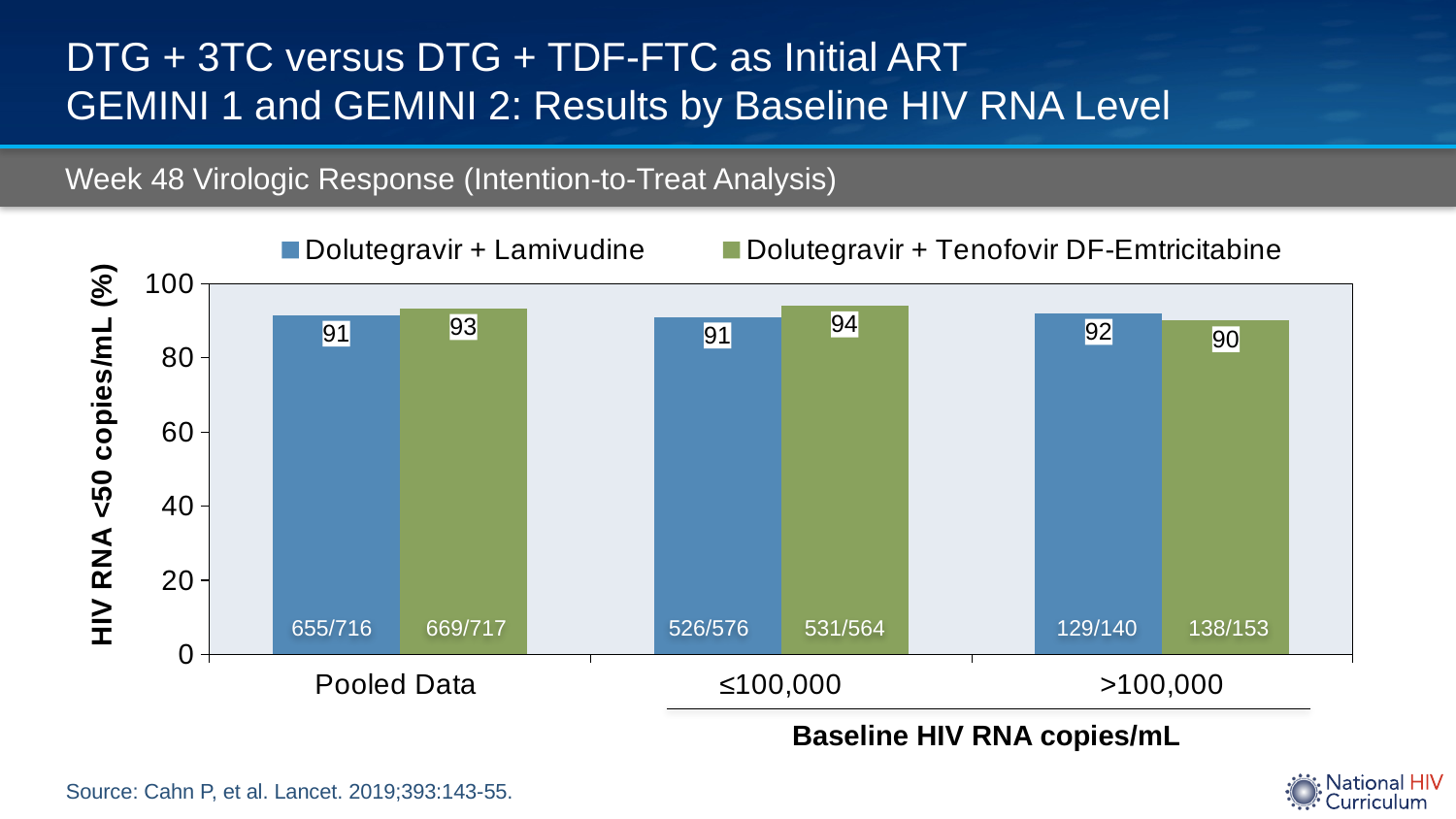
In the >100,000 category, which series has the larger value, Dolutegravir + Lamivudine or Dolutegravir + Tenofovir DF-Emtricitabine? Dolutegravir + Lamivudine What is the value for Dolutegravir + Tenofovir DF-Emtricitabine in the >100,000 category? 90 What is the value for Dolutegravir + Lamivudine in the Pooled Data category? 91 What is the difference between the Dolutegravir + Tenofovir DF-Emtricitabine and Dolutegravir + Lamivudine values in the ≤100,000 category? 3 What kind of chart is shown on the slide? Bar chart Which category has the highest value for Dolutegravir + Tenofovir DF-Emtricitabine? ≤100,000 How many series does the legend list? 2 Is the value for Dolutegravir + Lamivudine in the Pooled Data category greater or less than 80? greater How many baseline HIV RNA categories are shown on the x axis? 3 Which category has the lowest value for Dolutegravir + Tenofovir DF-Emtricitabine? >100,000 What is the value for Dolutegravir + Tenofovir DF-Emtricitabine in the ≤100,000 category? 94 What is the value for Dolutegravir + Lamivudine in the >100,000 category? 92